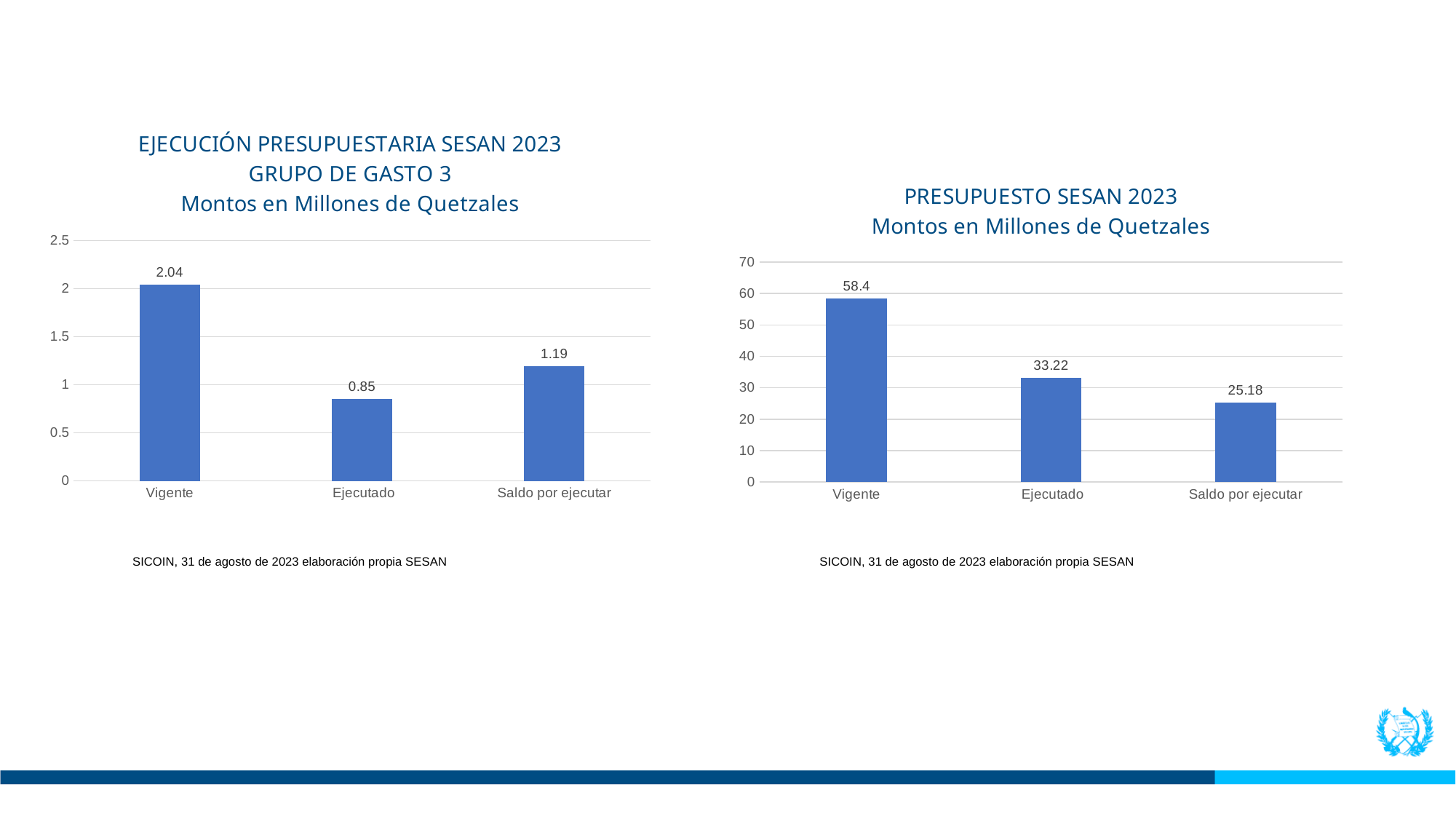
What type of chart is the left chart (GRUPO DE GASTO 3)? Bar chart In the right chart (PRESUPUESTO SESAN 2023), what is the value for Vigente? 58.4 In the right chart (PRESUPUESTO SESAN 2023), which category has the highest value? Vigente In the left chart (GRUPO DE GASTO 3), which category has the lowest value? Ejecutado How many categories are shown in the right chart (PRESUPUESTO SESAN 2023)? 3 In the left chart (GRUPO DE GASTO 3), is the value for Saldo por ejecutar greater or less than 1? greater In the left chart (GRUPO DE GASTO 3), what is the difference between Vigente and Saldo por ejecutar? 0.85 In the left chart (EJECUCIÓN PRESUPUESTARIA SESAN 2023 GRUPO DE GASTO 3), what is the value for Vigente? 2.04 In the right chart (PRESUPUESTO SESAN 2023), what is the difference between Ejecutado and Saldo por ejecutar? 8.04 In the right chart (PRESUPUESTO SESAN 2023), which is larger, Ejecutado or Saldo por ejecutar? Ejecutado In the left chart (GRUPO DE GASTO 3), what is the value for Ejecutado? 0.85 In the right chart (PRESUPUESTO SESAN 2023), what is the value for Saldo por ejecutar? 25.18